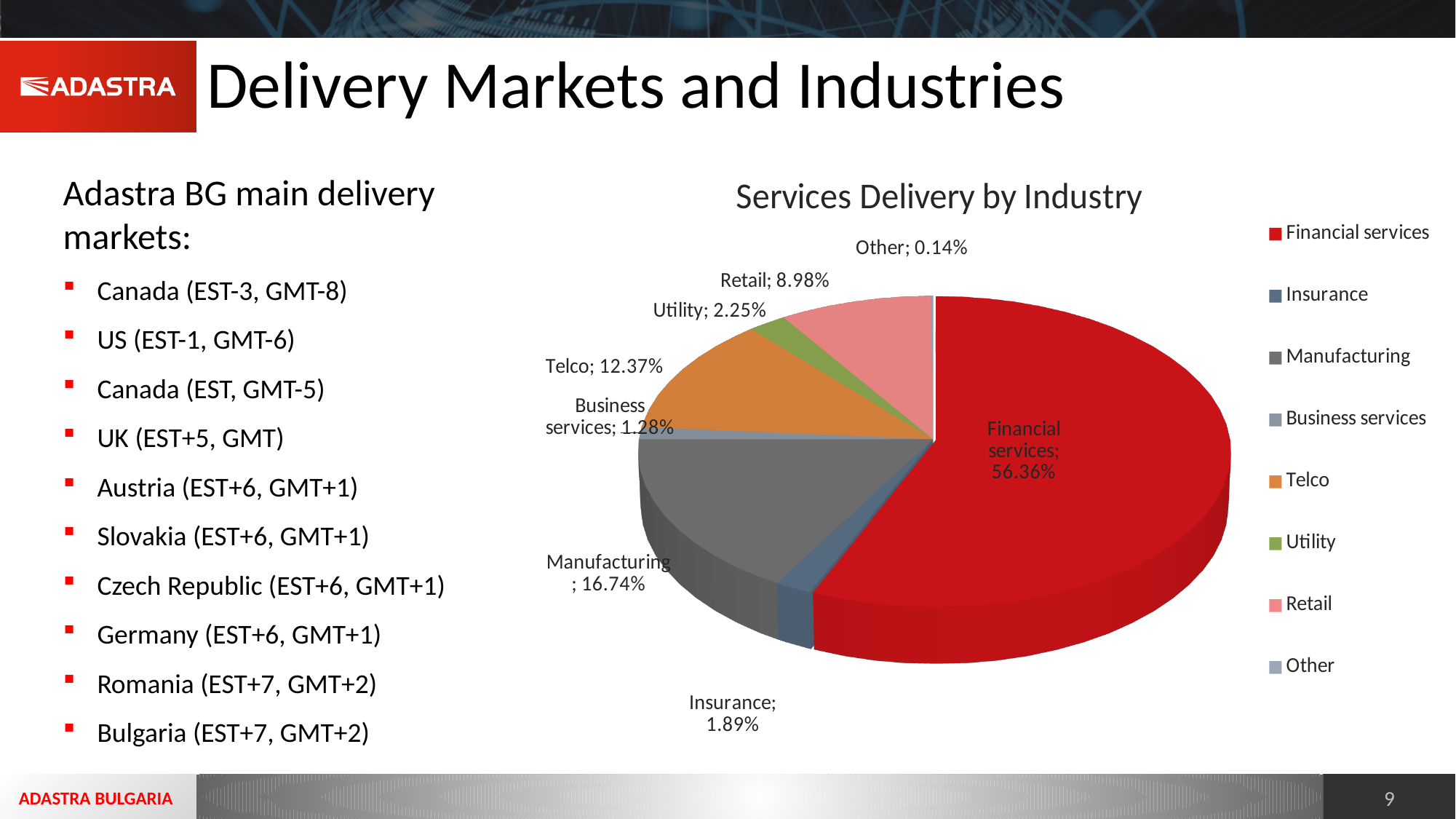
How many industry categories are shown in the pie chart? 8 Which industry has the smallest share of services delivery? Other What percentage does the Telco slice represent? 12.37% What is the title of the chart? Services Delivery by Industry What percentage is shown for Retail? 8.98% What type of chart is used to show Services Delivery by Industry? Pie chart What is the difference in percentage points between Manufacturing and Telco? 4.37 What share of services delivery is Financial services? 56.36% Which industry has the largest share of services delivery? Financial services Which is larger, the Utility share or the Insurance share? Utility What is the value shown for Manufacturing? 16.74% What colour is the Financial services slice? Red